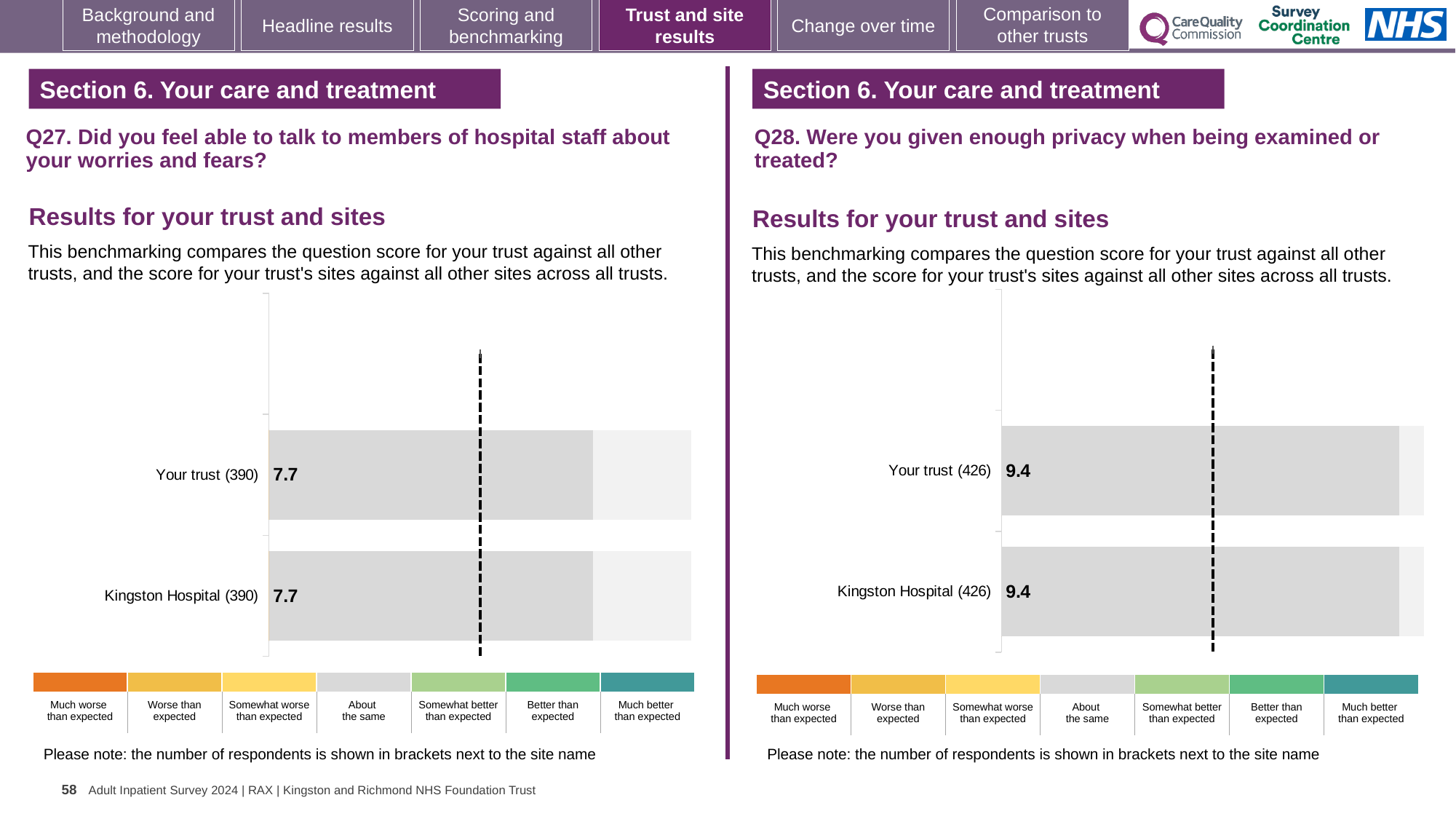
What kind of chart is the Q27 chart (left)? Bar chart On the Q28 chart (right), how many respondents are shown in brackets for Kingston Hospital? 426 On the Q28 chart (right), what is the score for Kingston Hospital? 9.4 On the Q27 chart (left), how many bars are plotted? 2 On the Q28 chart (right), how many bars are plotted? 2 How many categories does the colour key below the Q28 chart (right) list? 7 On the Q28 chart (right), what is the difference between the score for Your trust and the score for Kingston Hospital? 0 On the Q27 chart (left), what is the score for Kingston Hospital? 7.7 On the Q28 chart (right), what is the score for Your trust? 9.4 On the Q27 chart (left), what is the difference between the score for Your trust and the score for Kingston Hospital? 0 On the Q27 chart (left), how many respondents are shown in brackets for Your trust? 390 On the Q27 chart (left), what is the score for Your trust? 7.7